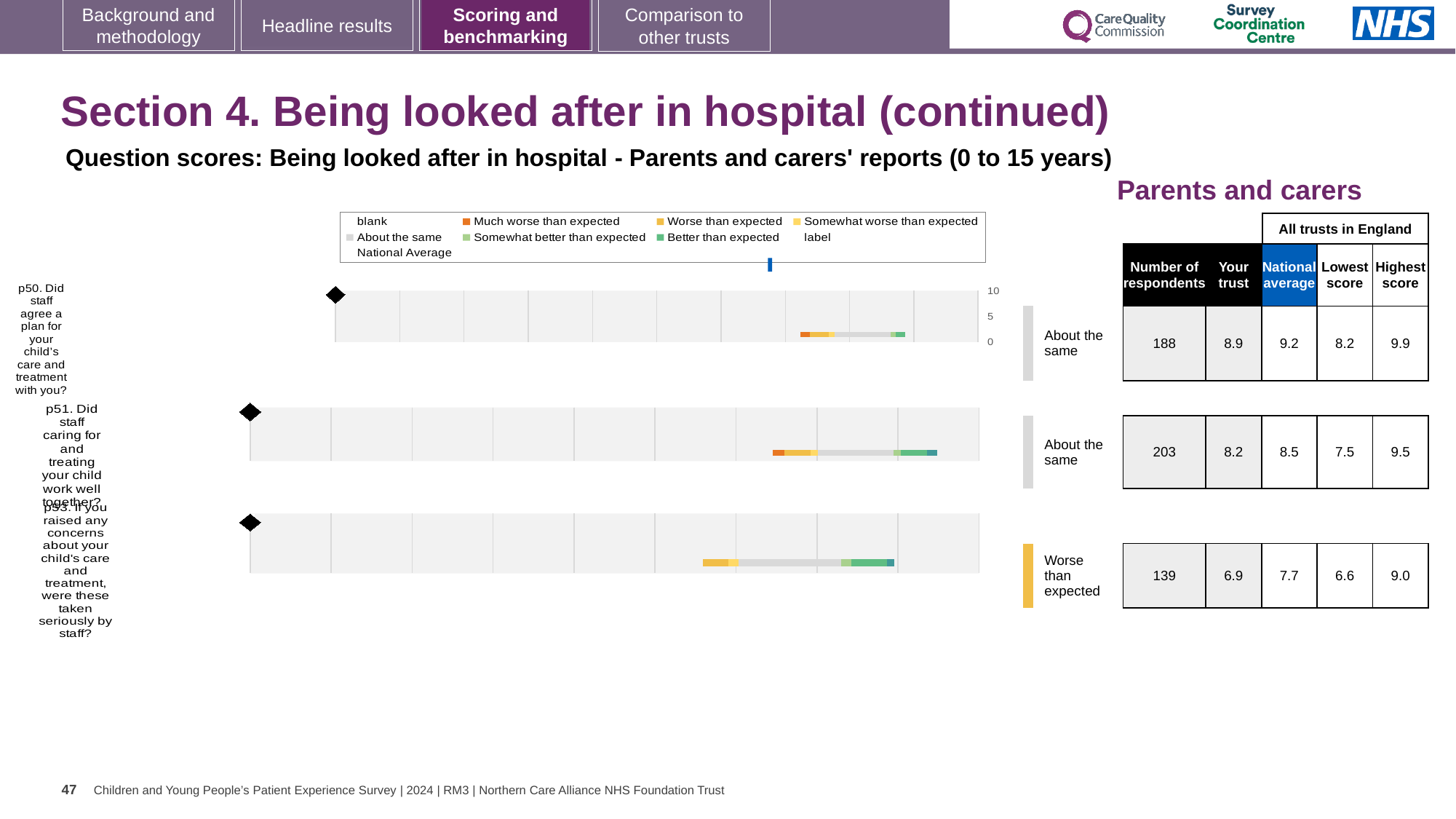
What is the 'Your trust' score for p50 (Did staff agree a plan for your child's care and treatment with you?)? 8.9 What kind of chart is used to show the question scores on this slide? bar chart How many respondents answered p53 (If you raised any concerns about your child's care and treatment, were these taken seriously by staff?)? 139 What is the highest score among all trusts in England for p53? 9.0 What is the difference between the national average and the 'Your trust' score for p53? 0.8 How many survey questions are plotted on the chart? 3 For p51, which is larger: the 'Your trust' score or the national average? National average Which benchmark category is shown for p53? Worse than expected Which question has the highest 'Your trust' score? p50 What is the national average score for p51 (Did staff caring for and treating your child work well together?)? 8.5 Which question has the lowest number of respondents? p53